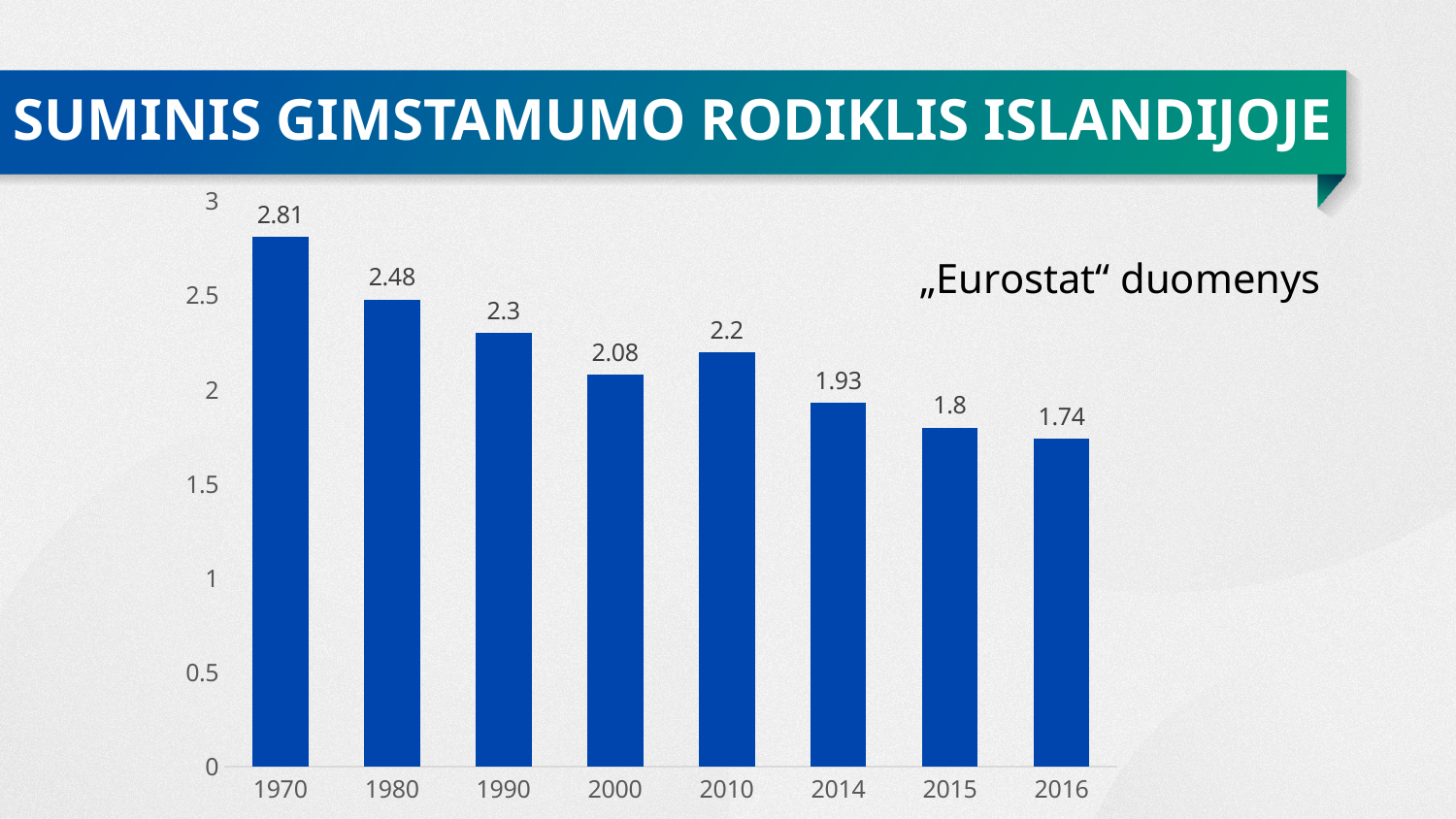
Is the value for 2015 greater or less than 2? less Do the values rise or fall from 1970 to 2016? fall What is the value for 2016? 1.74 Which year has the highest value? 1970 What is the difference between the values for 1970 and 2016? 1.07 What is the value for 1970? 2.81 Which is larger, the value for 2010 or the value for 2014? 2010 Which year has the lowest value? 2016 What is the value for 2000? 2.08 What kind of chart is shown on the slide? bar chart What is the difference between the values for 1980 and 1990? 0.18 How many years are shown on the x axis? 8